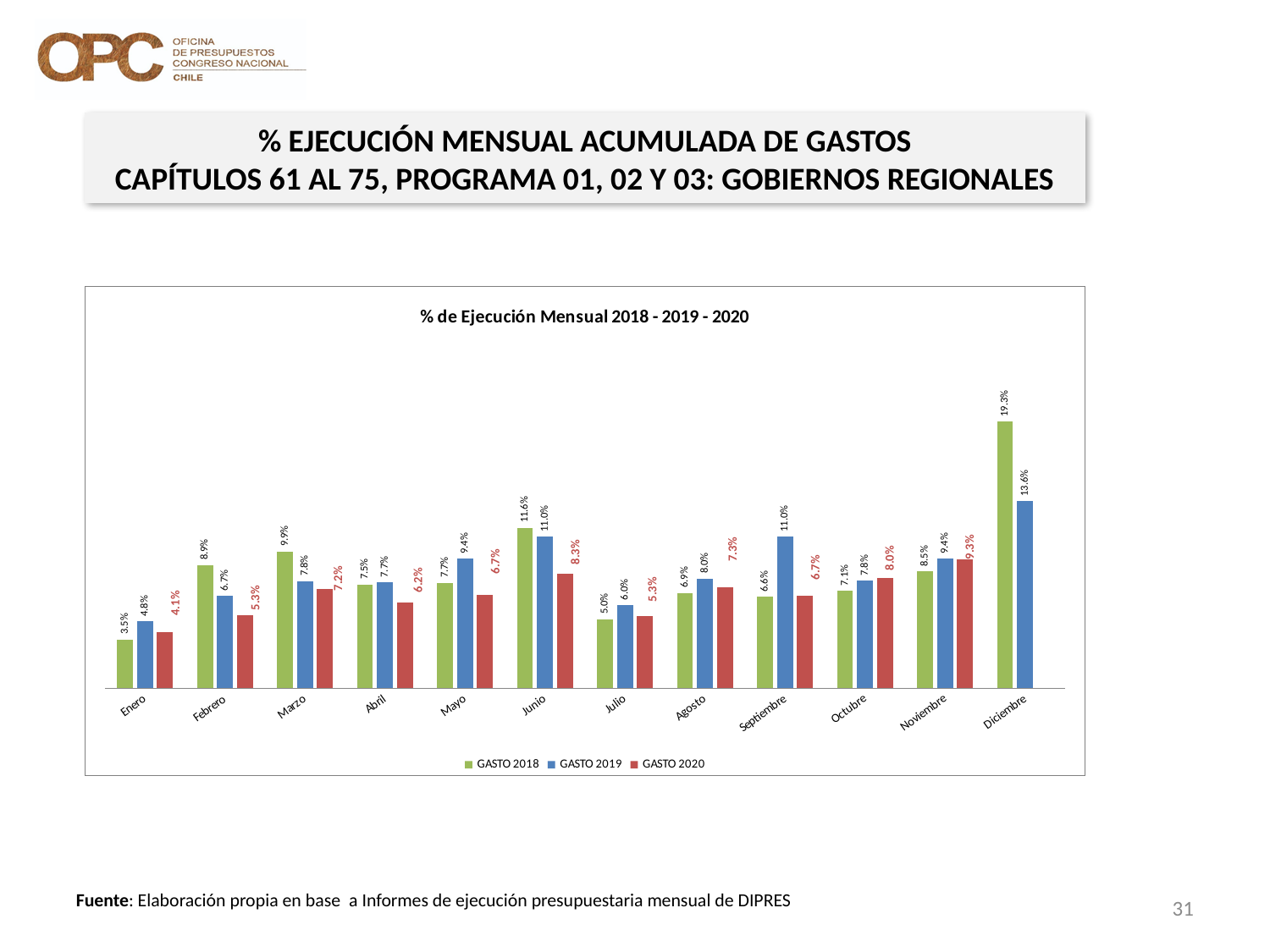
What is the difference between GASTO 2018 and GASTO 2019 in Diciembre? 5.7 percentage points Which month has the highest value for GASTO 2019? Diciembre What is the value for GASTO 2020 in Junio? 8.3% What kind of chart is shown on the slide? Bar chart How many series does the legend list? 3 In Septiembre, which is larger: GASTO 2018 or GASTO 2019? GASTO 2019 What is the value for GASTO 2019 in Septiembre? 11.0% What is the value for GASTO 2018 in Diciembre? 19.3% Which month has the lowest value for GASTO 2018? Enero Which month has the highest value for GASTO 2020? Noviembre How many months are shown on the x axis? 12 Do the GASTO 2018 values rise or fall from Enero to Marzo? Rise